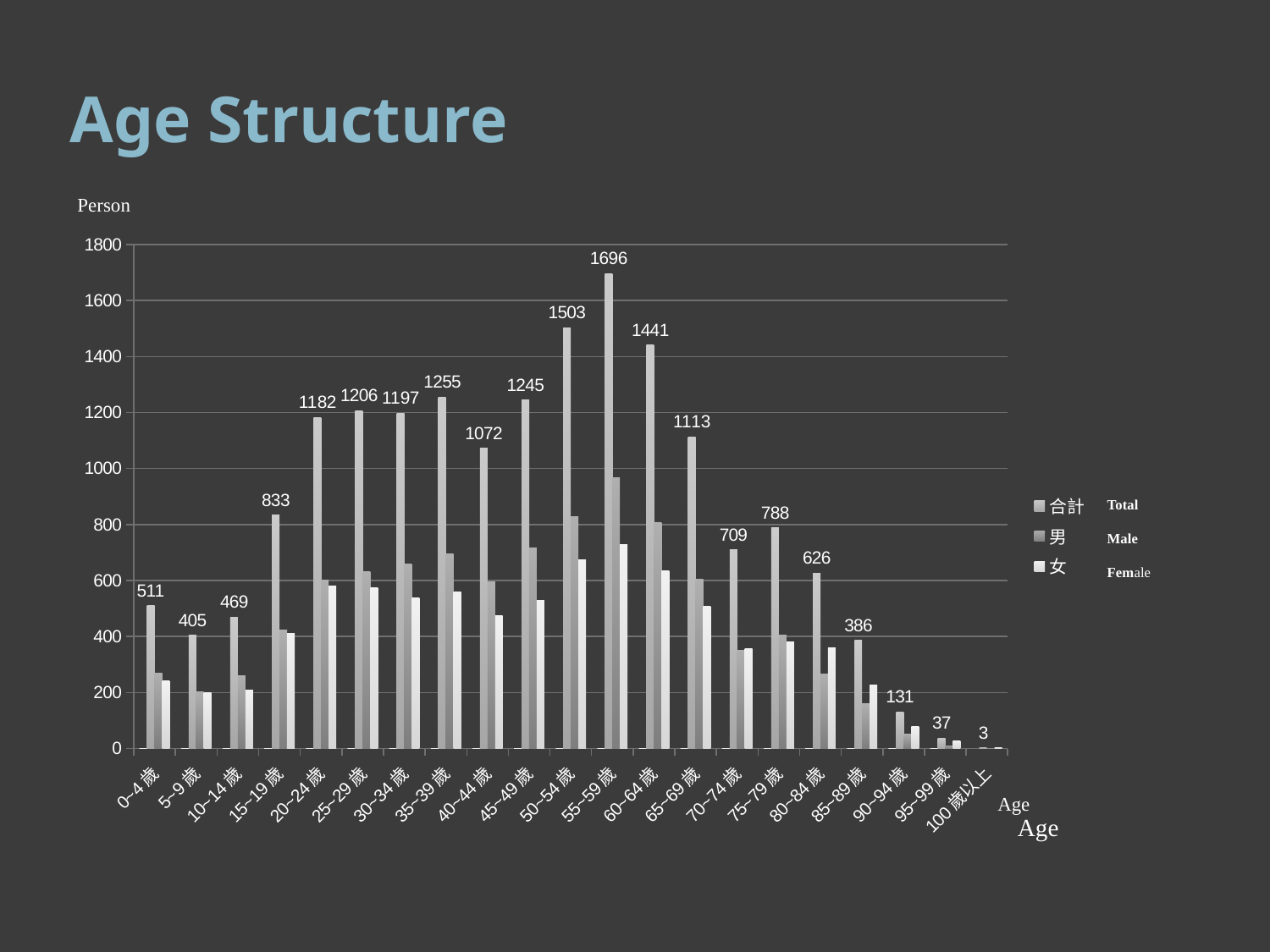
How many series does the legend list? 3 What is the Total value for the 0~4歲 age group? 511 What is the Total value for the 35~39歲 age group? 1255 Is the Female value for the 0~4歲 age group greater or less than 400? less What kind of chart is shown on the slide? Bar chart How many age groups are shown on the x axis? 21 What is the Total value for the 55~59歲 age group? 1696 Which age group has a larger Total value, 20~24歲 or 25~29歲? 25~29歲 Which age group has the highest Total value? 55~59歲 Which age group has the lowest Total value? 100歲以上 What is the difference between the Total values for 55~59歲 and 50~54歲? 193 Is the Male value for the 55~59歲 age group greater or less than 800? greater